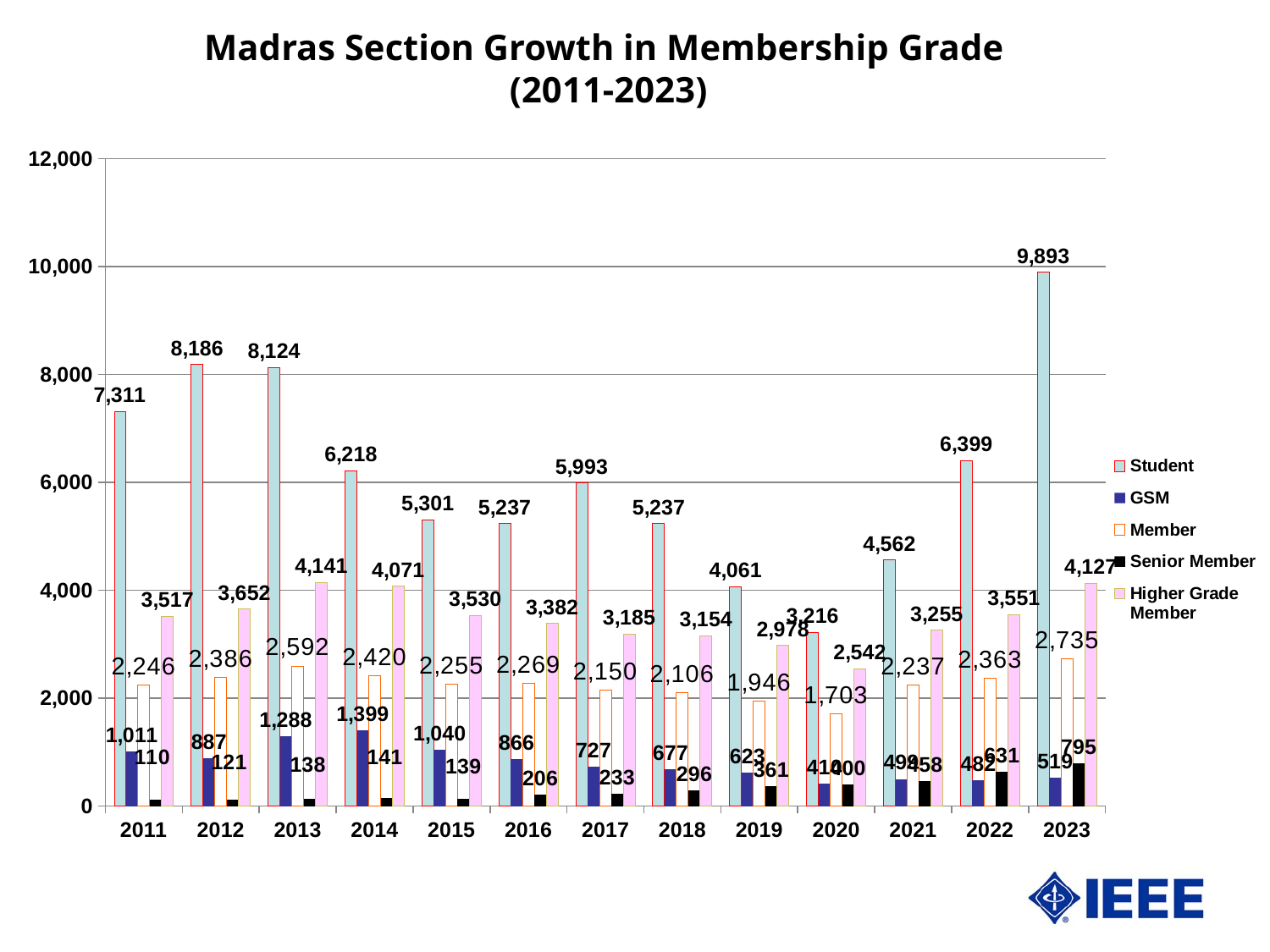
How many series does the legend list? 5 Which year has the larger Higher Grade Member value, 2013 or 2014? 2013 How many years are shown on the x axis? 13 What is the difference between the Student values for 2023 and 2022? 3,494 Is the Member value for 2020 greater or less than 2,000? less In which year is the Student value highest? 2023 What is the Higher Grade Member value for 2013? 4,141 Do the Senior Member values rise or fall from 2011 to 2023? Rise What is the Student value for 2023? 9,893 In which year is the Student value lowest? 2020 What is the Senior Member value for 2023? 795 What kind of chart is shown on the slide? Bar chart